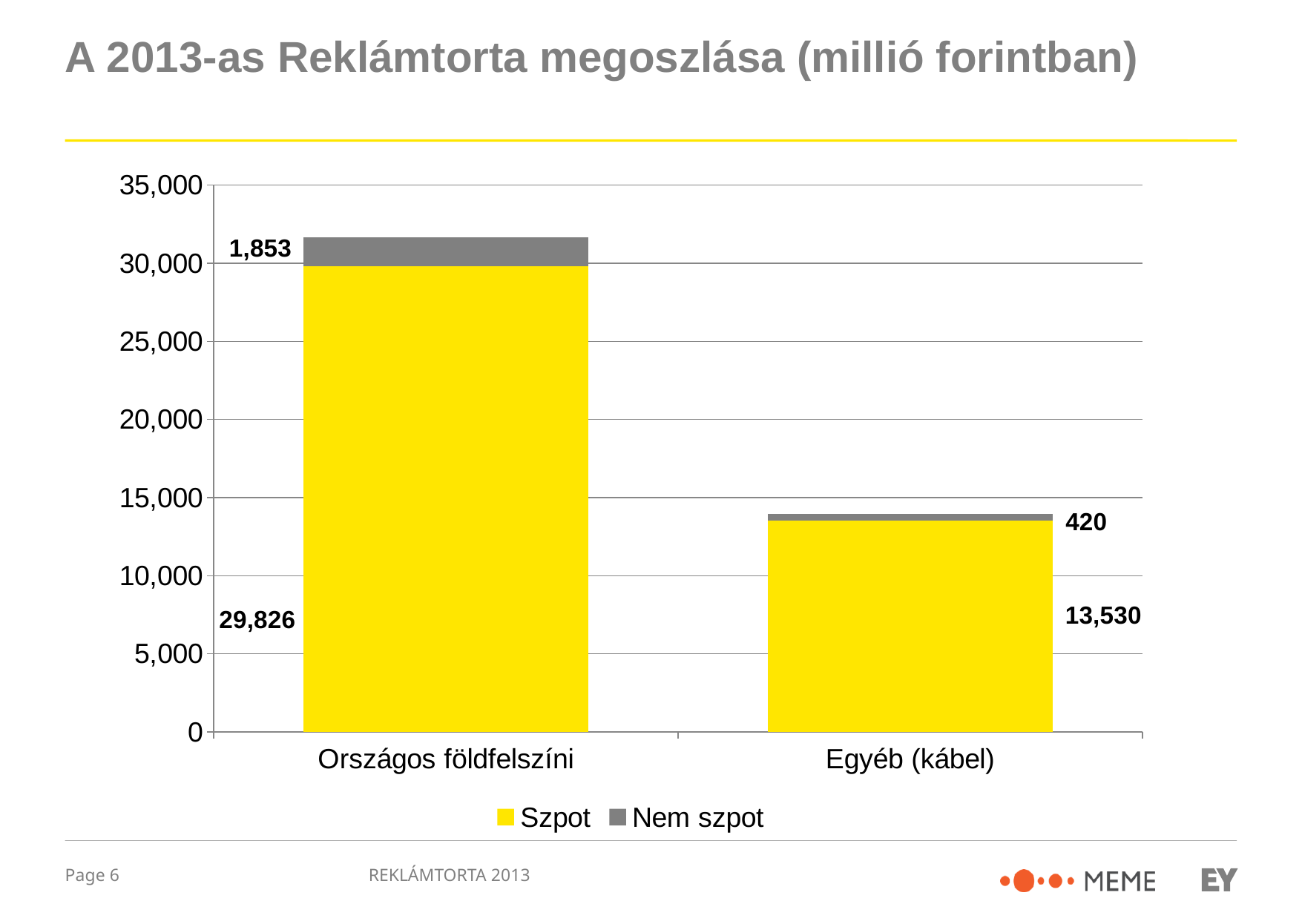
How many categories are shown on the x axis? 2 What is the Nem szpot value for Egyéb (kábel)? 420 Which category has the lower Nem szpot value? Egyéb (kábel) What kind of chart is shown on the slide? Stacked bar chart Which category has the higher Szpot value? Országos földfelszíni What is the total of the stacked bar for Egyéb (kábel)? 13,950 How many series does the legend list? 2 What is the difference between the Szpot values for Országos földfelszíni and Egyéb (kábel)? 16,296 What is the Szpot value for Egyéb (kábel)? 13,530 What is the Nem szpot value for Országos földfelszíni? 1,853 What is the total of the stacked bar for Országos földfelszíni? 31,679 What is the Szpot value for Országos földfelszíni? 29,826